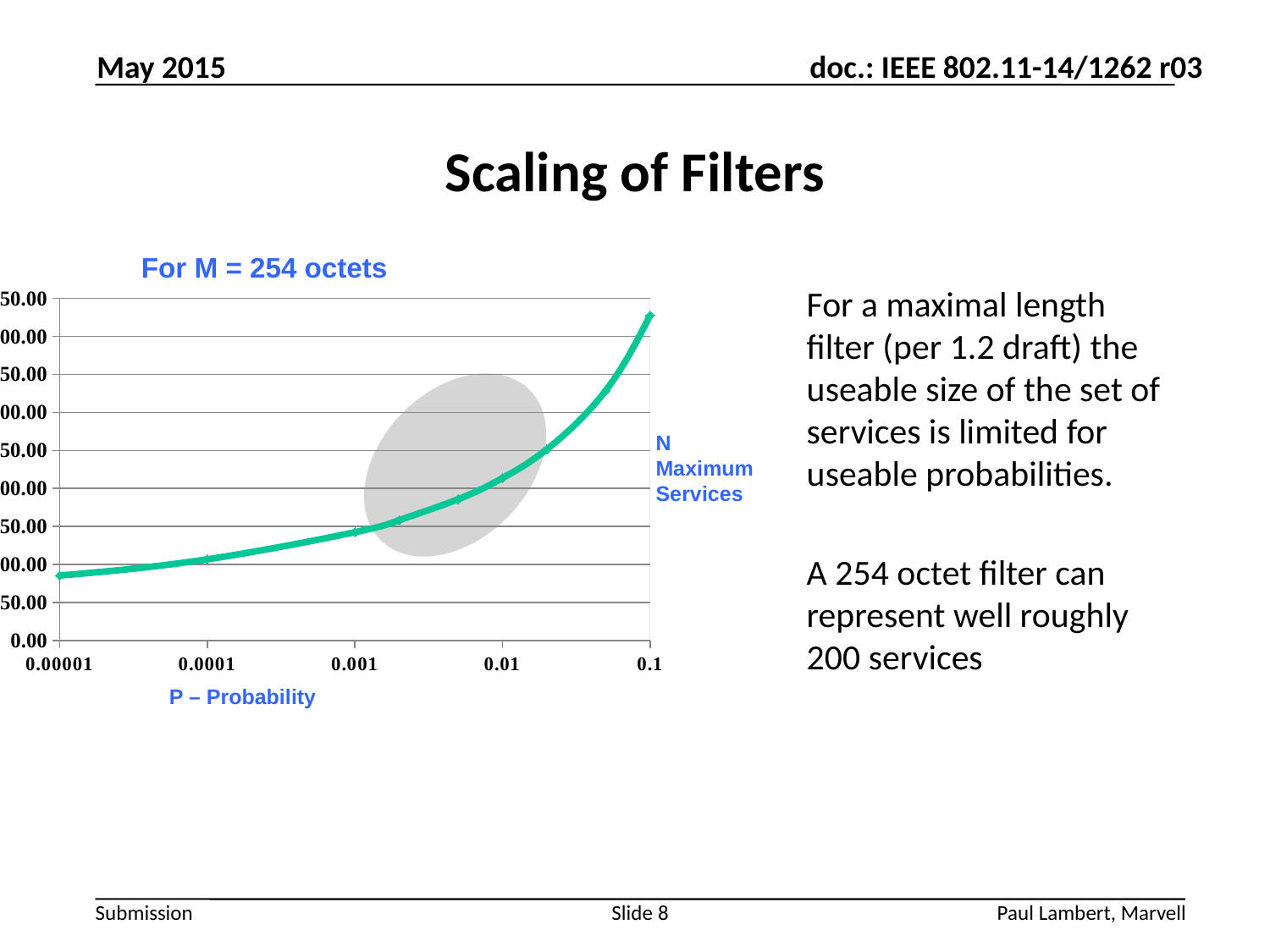
What is the largest value labelled on the x axis? 0.1 Do the values of N Maximum Services rise or fall as P – Probability increases along the x axis? rise Which has the larger value of N Maximum Services: P = 0.1 or P = 0.00001? 0.1 What is the smallest value labelled on the x axis? 0.00001 What is the title of the chart? For M = 254 octets How many tick labels are shown on the x axis of the chart? 5 At which x-axis value is N Maximum Services highest? 0.1 Which has the larger value of N Maximum Services: P = 0.001 or P = 0.01? 0.01 What kind of chart is shown on the slide? line chart What is the label of the x axis of the chart? P – Probability How many series are plotted in the chart? 1 At which x-axis value is N Maximum Services lowest? 0.00001